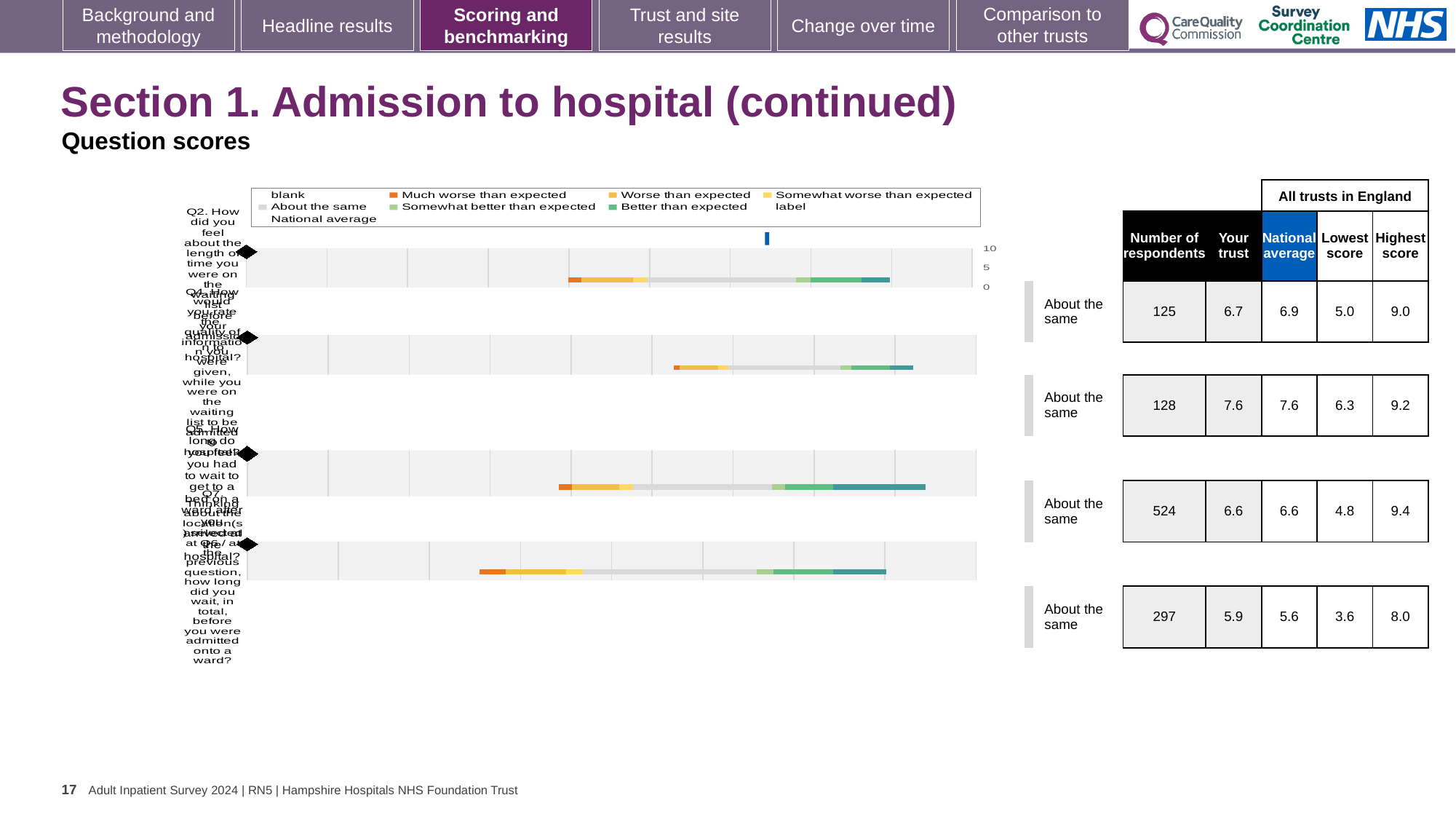
Which legend entry is shown in orange-red, immediately after 'blank'? Much worse than expected What benchmark category label is shown to the right of each of the four bars? About the same How many entries does the chart legend list? 9 What is the highest value shown on the chart's axis? 10 What kind of chart is shown on the slide? bar chart How many horizontal bars are plotted in the chart? 4